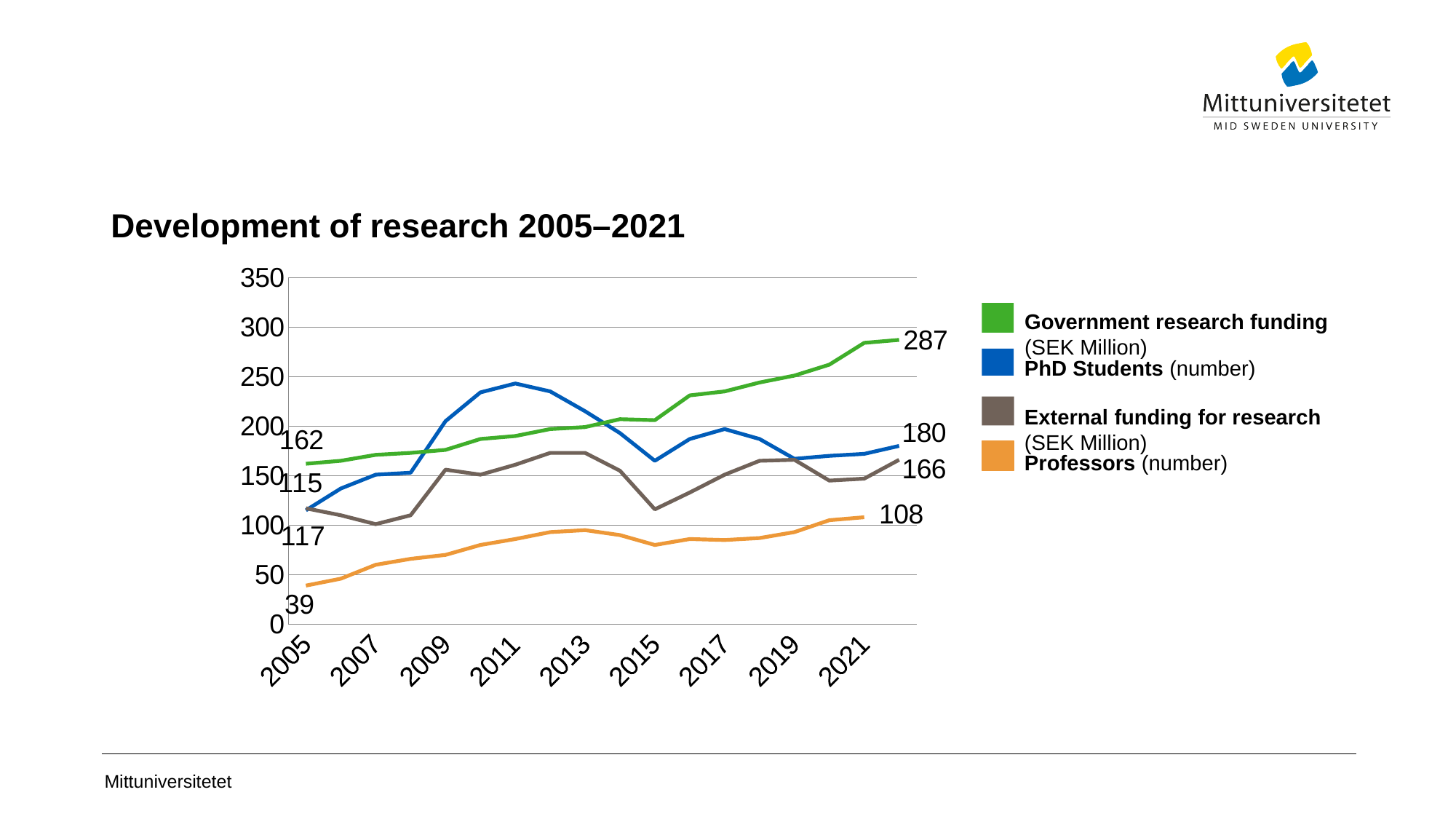
Is the number of PhD Students in 2011 greater or less than 200? greater What kind of chart is shown on the slide? line chart Does Government research funding generally rise or fall from 2005 to 2021? rise What is the number of Professors in 2005? 39 What is the number of Professors in 2021? 108 Which series has the highest value in 2021? Government research funding How many series does the legend list? 4 What is the value of Government research funding (SEK Million) in 2005? 162